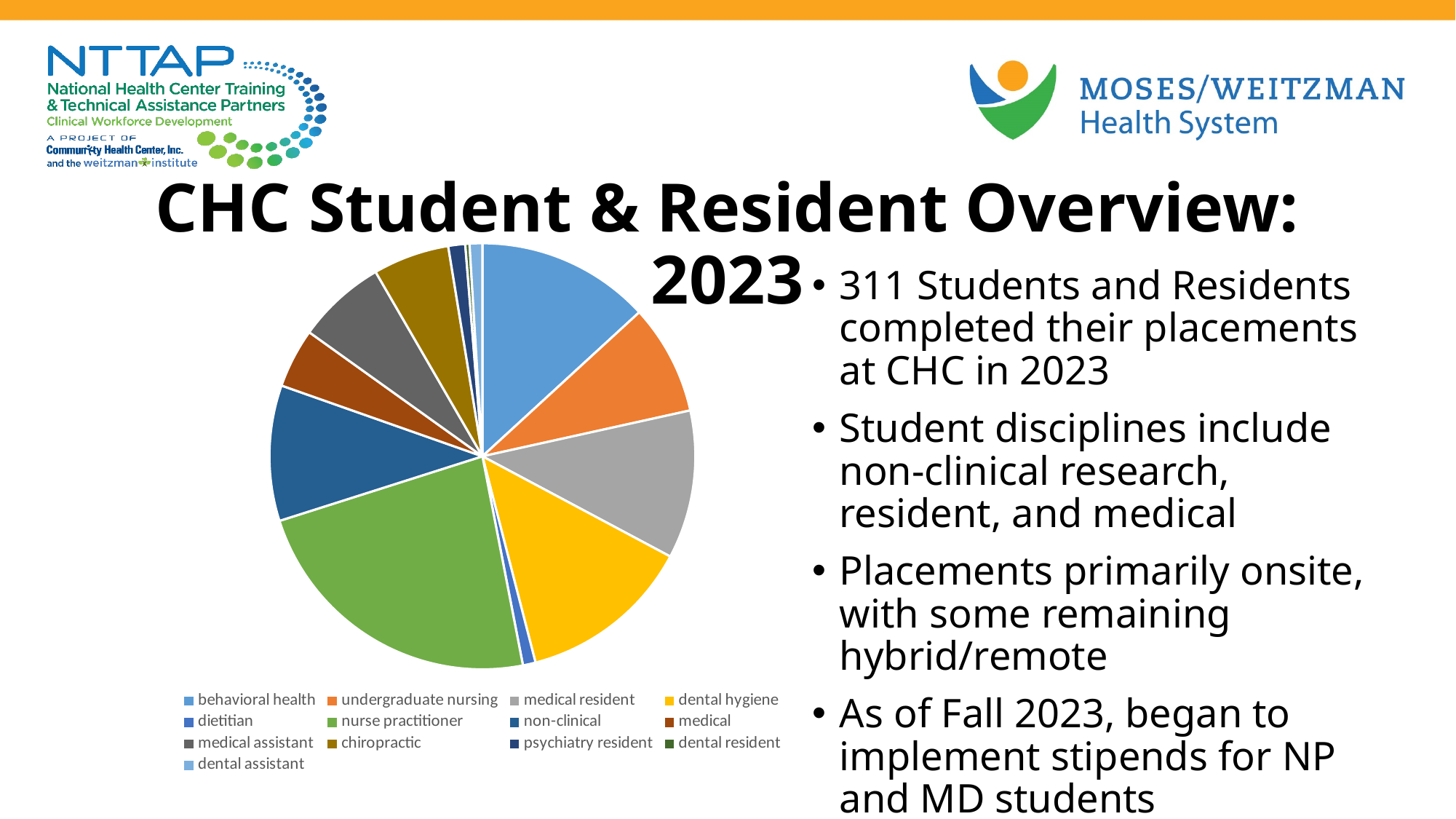
Which slice is larger in the pie chart: non-clinical or psychiatry resident? non-clinical What colour represents dental hygiene in the pie chart? yellow Which slice is larger in the pie chart: nurse practitioner or behavioral health? nurse practitioner How many categories does the pie chart's legend list? 13 Which slice is larger in the pie chart: medical resident or medical? medical resident Which category has the largest slice of the pie chart? nurse practitioner What colour represents nurse practitioner in the pie chart? green What kind of chart is shown on the slide? pie chart